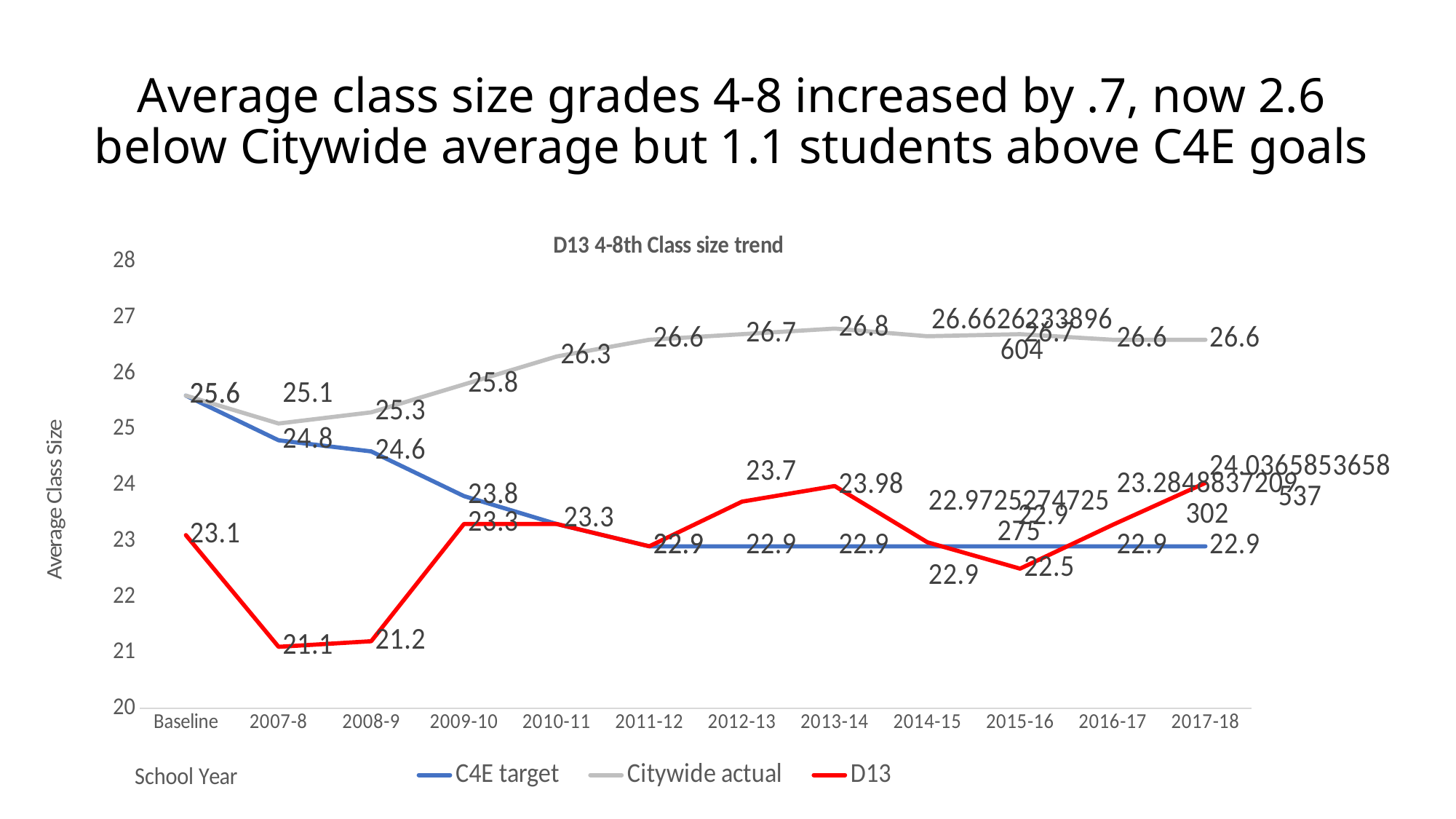
How many series does the legend list? 3 What is the difference between the Citywide actual and D13 values in 2013-14? 2.82 What is the Citywide actual value for 2013-14? 26.8 What is the D13 value for 2007-8? 21.1 What type of chart is shown on the slide? Line chart In which school year is the Citywide actual value highest? 2013-14 In 2012-13, which is larger: the D13 value or the C4E target value? D13 What is the C4E target value for 2008-9? 24.6 How many school years (categories) are shown on the x axis? 12 Does the C4E target rise or fall from Baseline to 2011-12? Fall In which school year is the D13 value lowest? 2007-8 What is the D13 value for 2015-16? 22.5